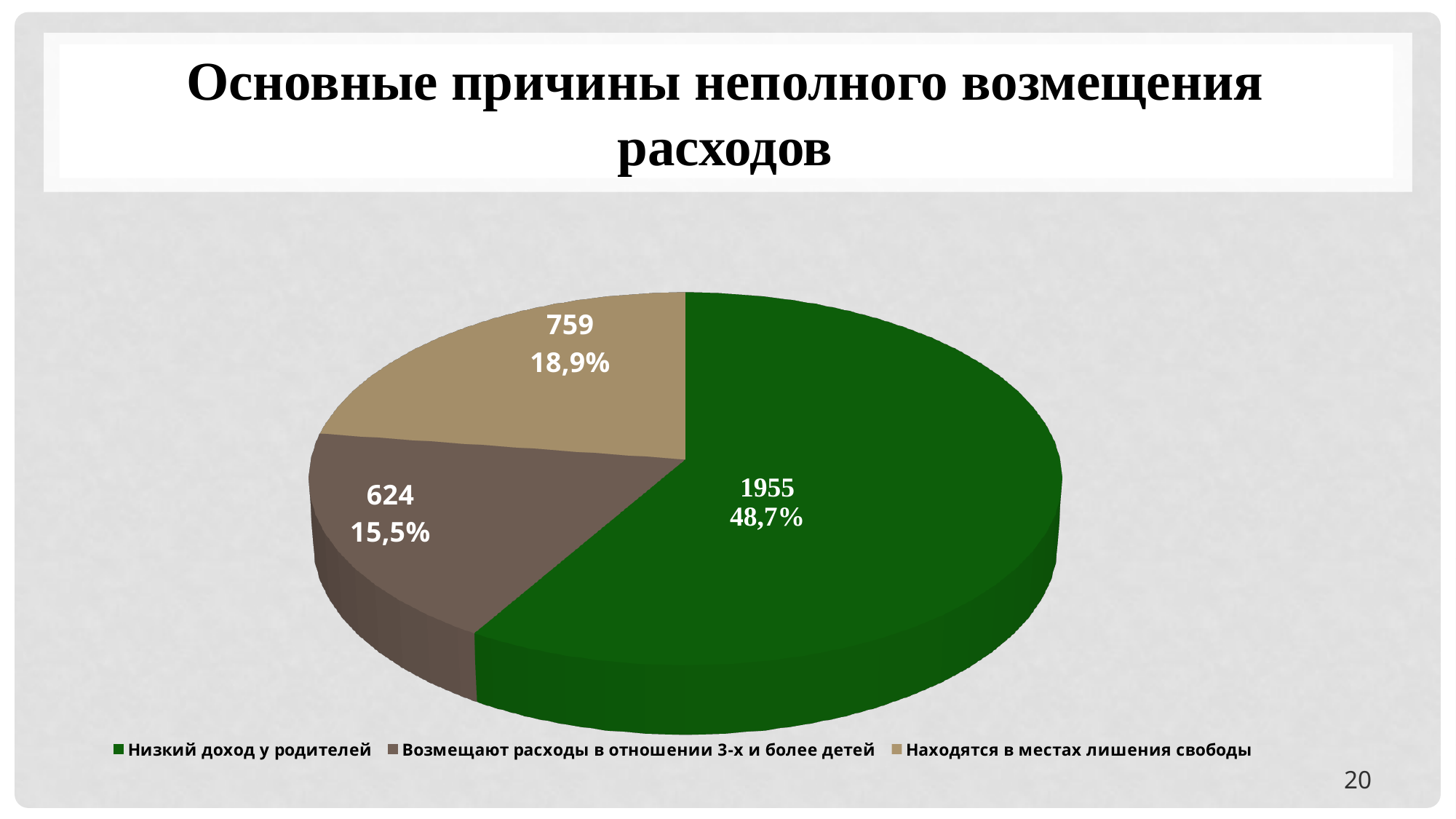
Which category has the largest slice? Низкий доход у родителей What share of the pie does "Низкий доход у родителей" represent, as printed on the slide? 48,7% What share of the pie does "Находятся в местах лишения свободы" represent, as printed on the slide? 18,9% Which category has the smallest slice? Возмещают расходы в отношении 3-х и более детей What kind of chart is shown on the slide? Pie chart What is the value for "Низкий доход у родителей"? 1955 What is the value for "Возмещают расходы в отношении 3-х и более детей"? 624 What share of the pie does "Возмещают расходы в отношении 3-х и более детей" represent, as printed on the slide? 15,5% Which is larger: the value for "Находятся в местах лишения свободы" or the value for "Возмещают расходы в отношении 3-х и более детей"? Находятся в местах лишения свободы What is the difference between the values for "Низкий доход у родителей" and "Находятся в местах лишения свободы"? 1196 How many categories does the pie chart show? 3 What is the value for "Находятся в местах лишения свободы"? 759